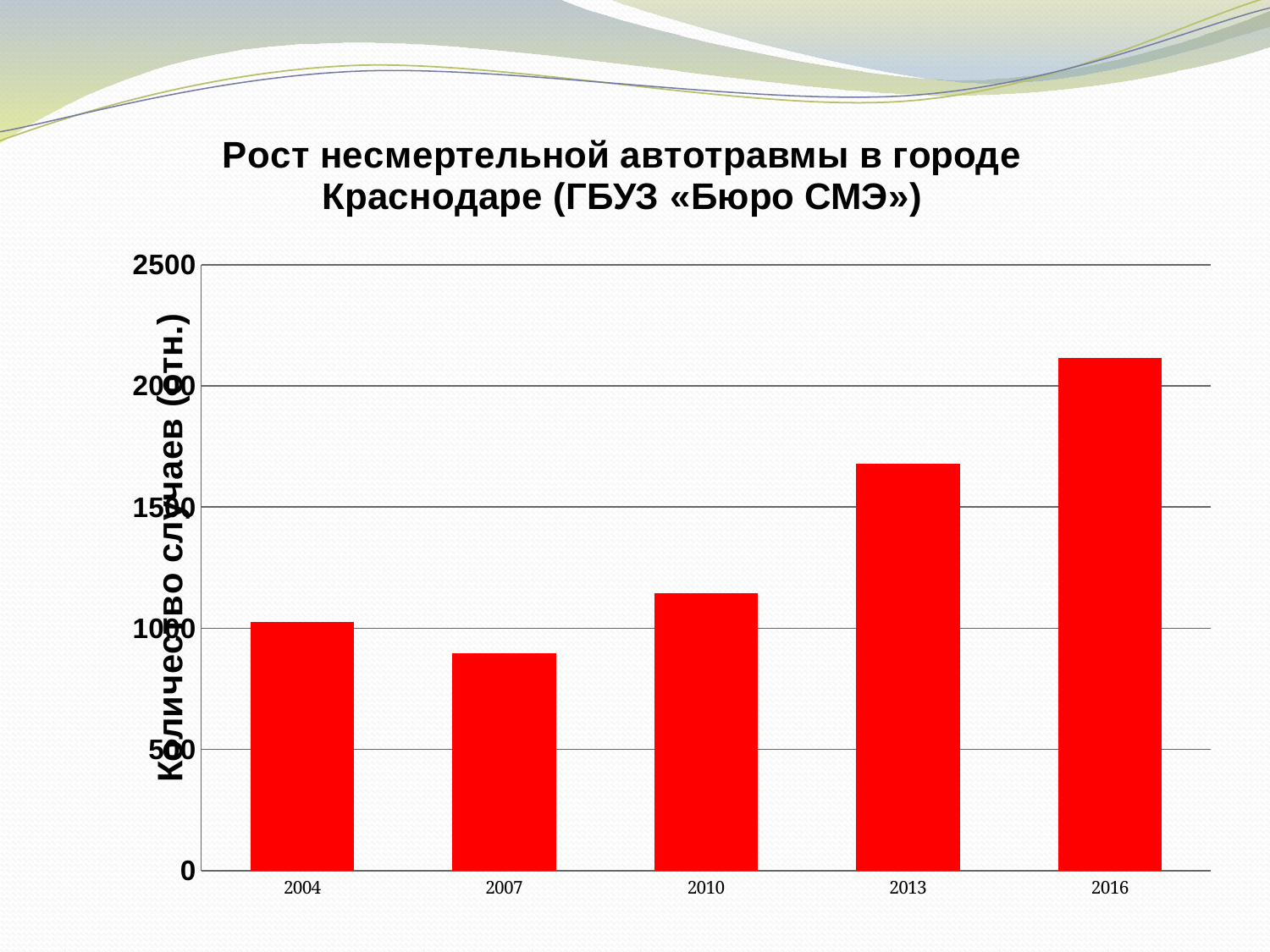
What colour are the bars in the chart? red Is the value for 2013 greater or less than 2000? less Is the value for 2013 greater or less than 1500? greater Which year has the larger value, 2010 or 2013? 2013 Is the value for 2016 greater or less than 2000? greater Which year has the lowest number of cases in the chart? 2007 How many years are shown on the x axis of the chart? 5 Which year has the highest number of cases in the chart? 2016 Do the values generally rise or fall from 2007 to 2016? rise What kind of chart is shown on the slide? bar chart